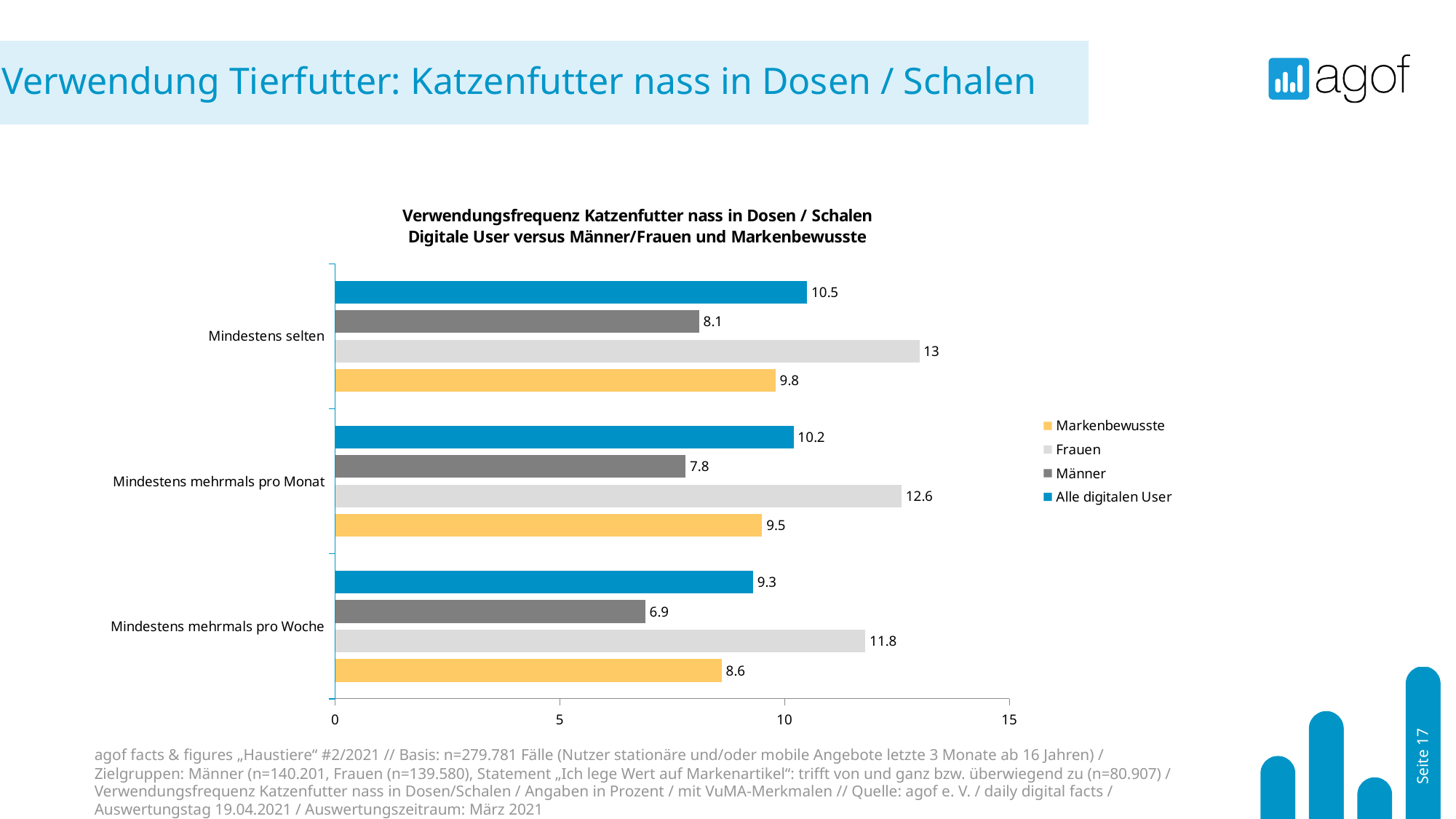
What is the value for Alle digitalen User in the 'Mindestens mehrmals pro Woche' category? 9.3 How many series does the legend list? 4 Which is larger: the Alle digitalen User value for 'Mindestens selten' or the Markenbewusste value for 'Mindestens selten'? Alle digitalen User What is the difference between the Frauen and Männer values in the 'Mindestens mehrmals pro Woche' category? 4.9 Which series has the highest value in the 'Mindestens selten' category? Frauen Is the value for Frauen in 'Mindestens mehrmals pro Monat' greater or less than 10? greater What is the value for Männer in the 'Mindestens mehrmals pro Woche' category? 6.9 What is the value for Markenbewusste in the 'Mindestens mehrmals pro Monat' category? 9.5 Which series has the lowest value in the 'Mindestens mehrmals pro Monat' category? Männer What is the value for Frauen in the 'Mindestens selten' category? 13 What kind of chart is shown on the slide? Bar chart How many categories are shown on the y axis of the chart? 3